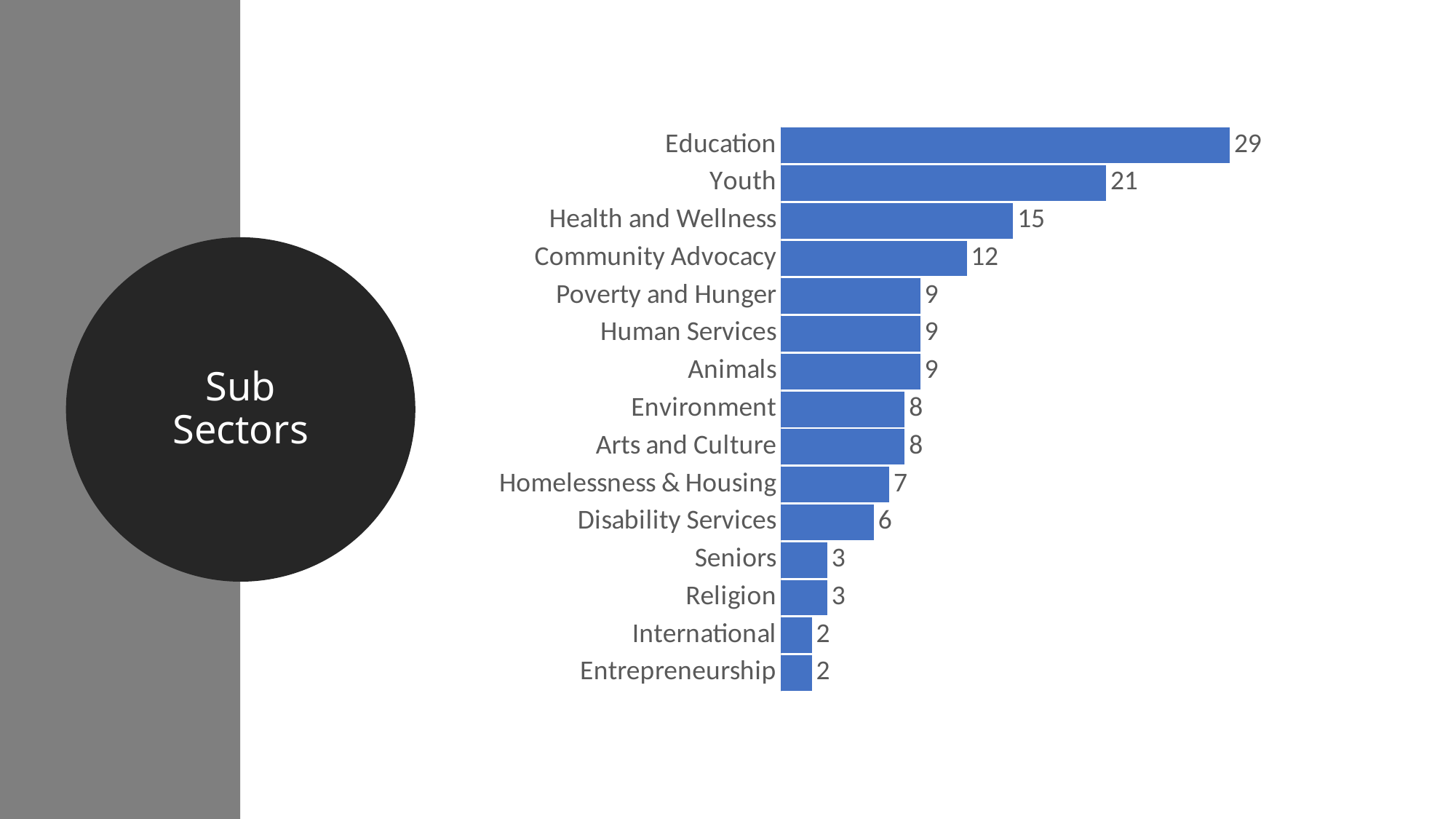
What is the difference between the values for Education and Youth? 8 How many categories are shown in the chart? 15 Which is larger, the value for Environment or the value for Disability Services? Environment What kind of chart is shown on the slide? Bar chart What is the value for Disability Services? 6 What is the value for Health and Wellness? 15 Which category has the highest value? Education What is the difference between the values for Community Advocacy and Seniors? 9 Which is larger, the value for Youth or the value for Health and Wellness? Youth What is the value for Education? 29 What is the value for Homelessness & Housing? 7 What is the title shown in the circle on the slide? Sub Sectors